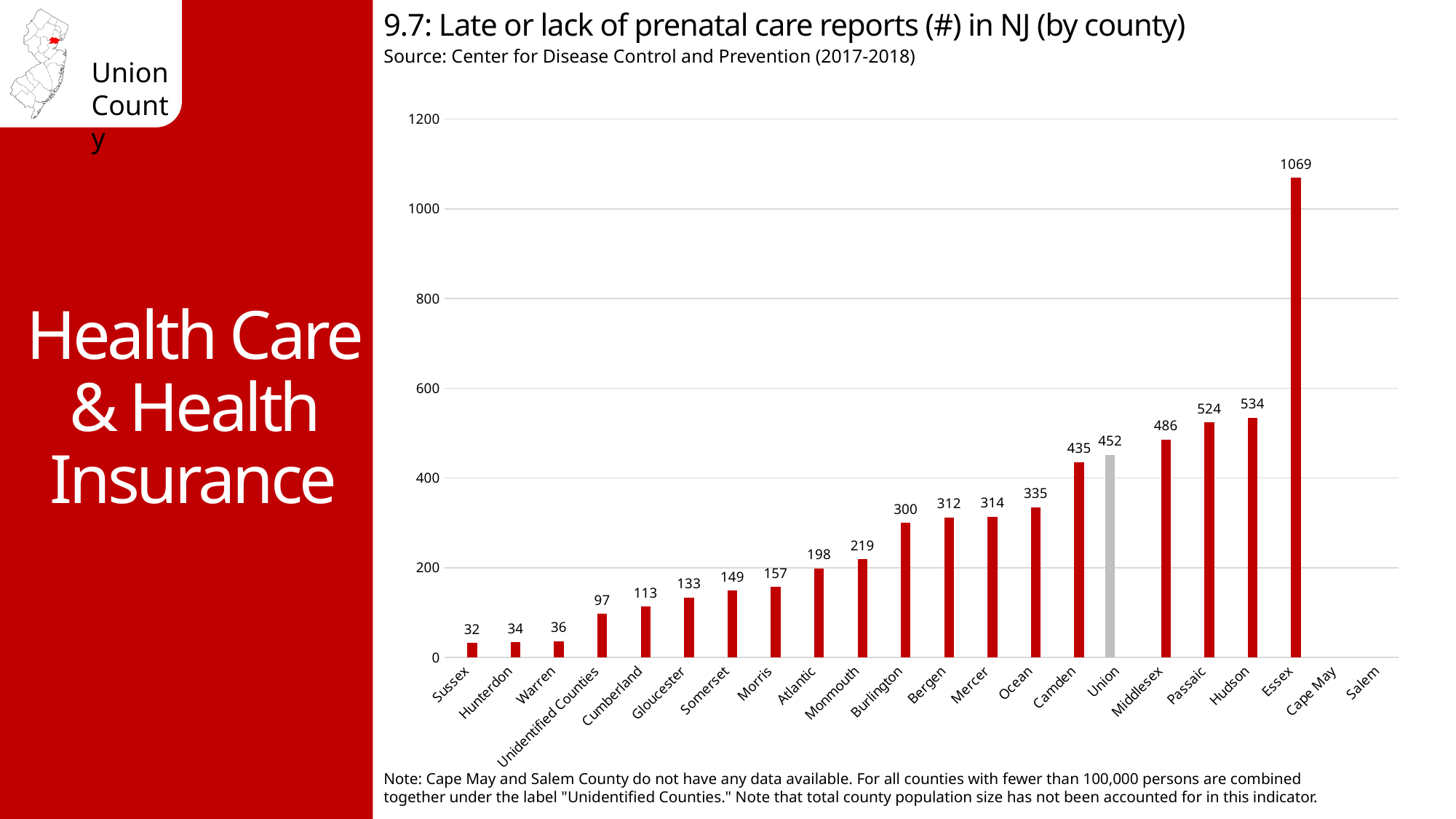
Which county has the highest number of late or lack of prenatal care reports? Essex What is the value shown for Unidentified Counties? 97 How many counties are labeled on the x axis? 22 Which county with a plotted value has the lowest number of reports? Sussex What kind of chart is shown on the slide? Bar chart Is the value for Monmouth greater or less than 200? greater Which two counties are listed on the x axis with no data available? Cape May and Salem What is the difference between the values for Hudson and Passaic? 10 What is the number of late or lack of prenatal care reports for Union County? 452 What is the value shown for Essex? 1069 What is the difference between the values for Essex and Union? 617 Which has a larger value, Camden or Middlesex? Middlesex